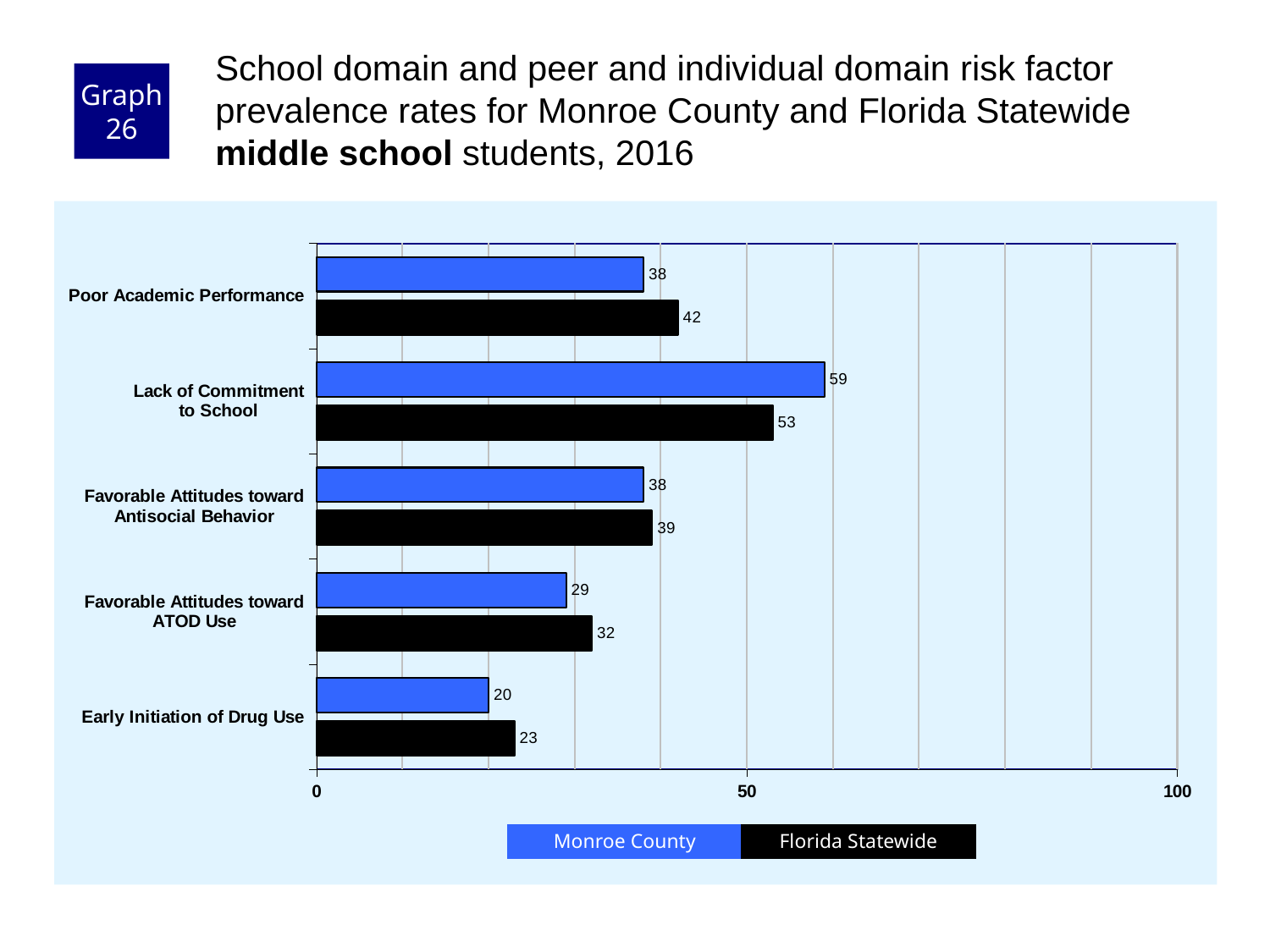
Which risk factor has the highest Monroe County value? Lack of Commitment to School How many risk factor categories are shown on the chart? 5 What is the difference between the Florida Statewide and Monroe County values for Poor Academic Performance? 4 What kind of chart is shown on the slide? bar chart Is the Monroe County value for Lack of Commitment to School greater or less than 50? greater What is the Florida Statewide value for Early Initiation of Drug Use? 23 What is the Monroe County value for Lack of Commitment to School? 59 Which colour represents Florida Statewide in the chart? black Which risk factor has the lowest Florida Statewide value? Early Initiation of Drug Use For Lack of Commitment to School, which is larger: the Monroe County value or the Florida Statewide value? Monroe County How many series does the legend list? 2 What is the Florida Statewide value for Favorable Attitudes toward ATOD Use? 32